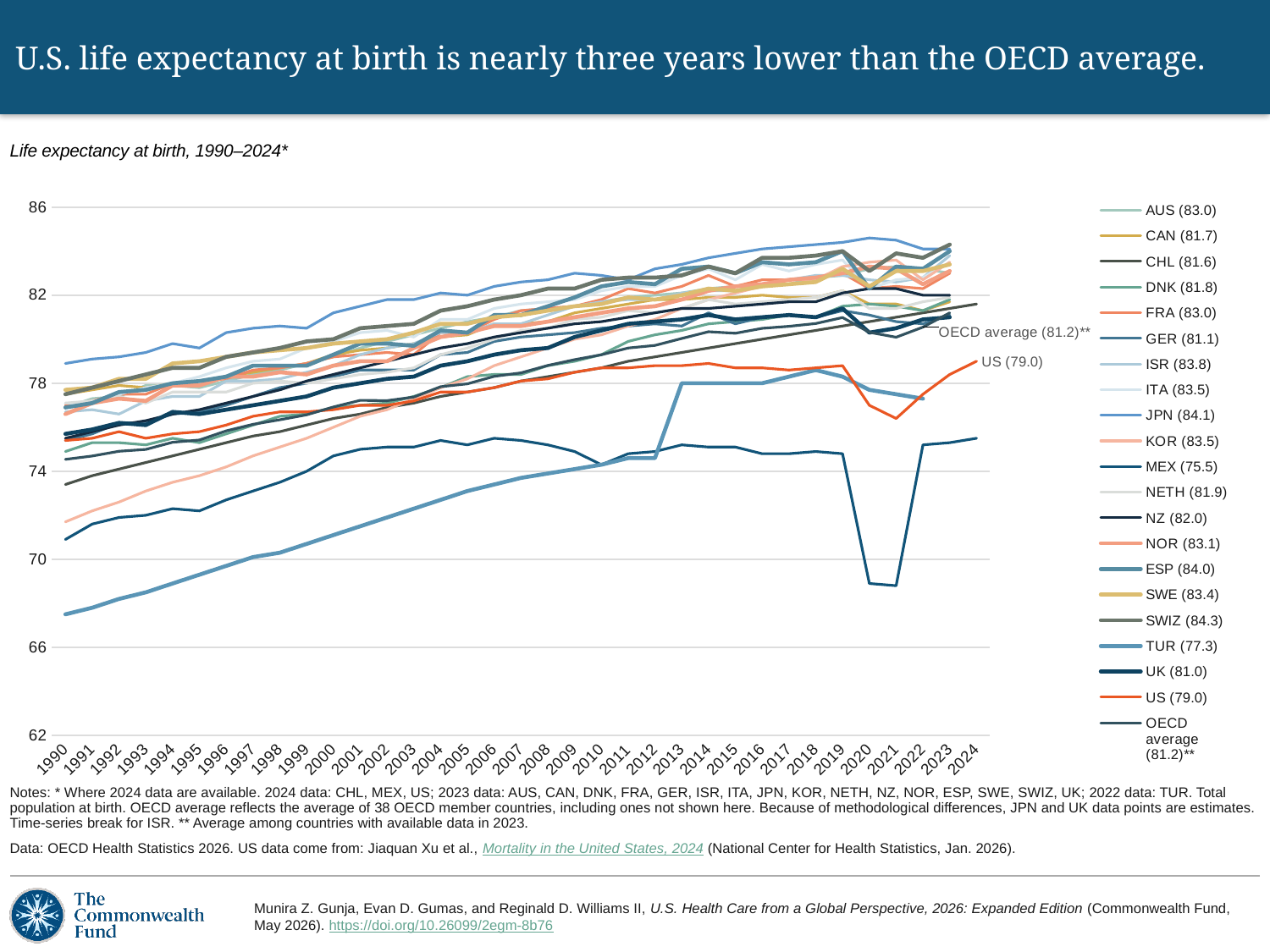
What kind of chart is shown on the slide? Line chart What is the OECD average life expectancy shown in the legend? 81.2 Is the US life expectancy value in 1990 greater or less than 78? less Which country has the highest latest life expectancy value in the legend? SWIZ (84.3) What is the latest life expectancy value shown for the US in the legend? 79.0 Which has a higher latest life expectancy value, ESP or ISR? ESP Which country has the lowest latest life expectancy value in the legend? MEX (75.5) What is the latest life expectancy value shown for JPN? 84.1 Is the MEX life expectancy value in 2021 greater or less than 70? less How many series does the legend list? 21 Does the US life expectancy line generally rise or fall from 1990 to 2019? Rise How much lower is the US latest life expectancy than the OECD average shown in the legend? 2.2